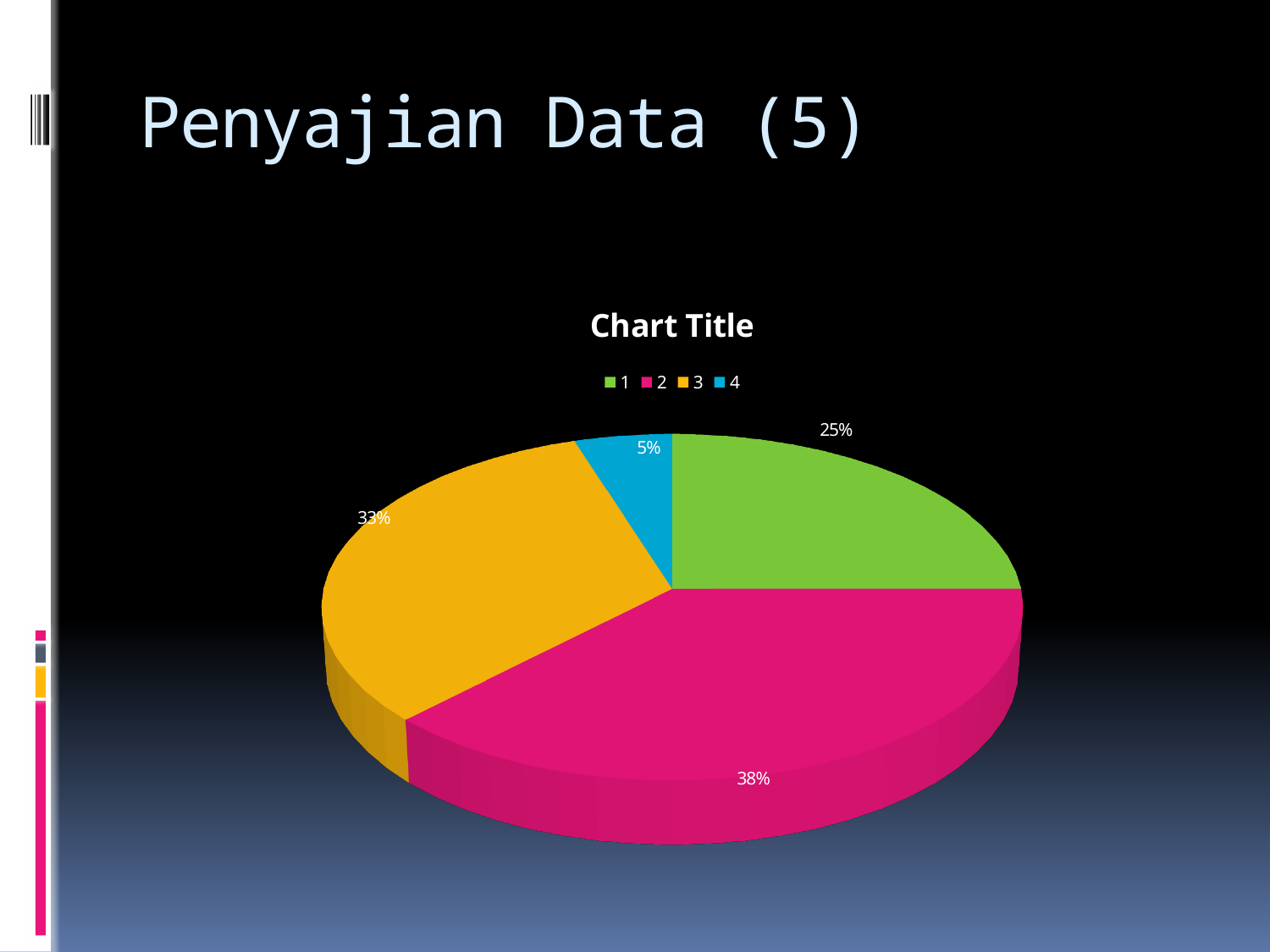
What is the title of the chart? Chart Title What percentage does category 3 represent in the pie chart? 33% Which category has the largest share of the pie chart? 2 What percentage does category 2 represent in the pie chart? 38% What percentage does category 4 represent in the pie chart? 5% How many slices does the pie chart have? 4 What is the difference in percentage points between category 2 and category 1? 13 Which category has the smallest share of the pie chart? 4 Which is larger, the share of category 1 or the share of category 3? 3 What kind of chart is shown on the slide? pie chart What colour is the slice for category 4? blue What percentage does category 1 represent in the pie chart? 25%